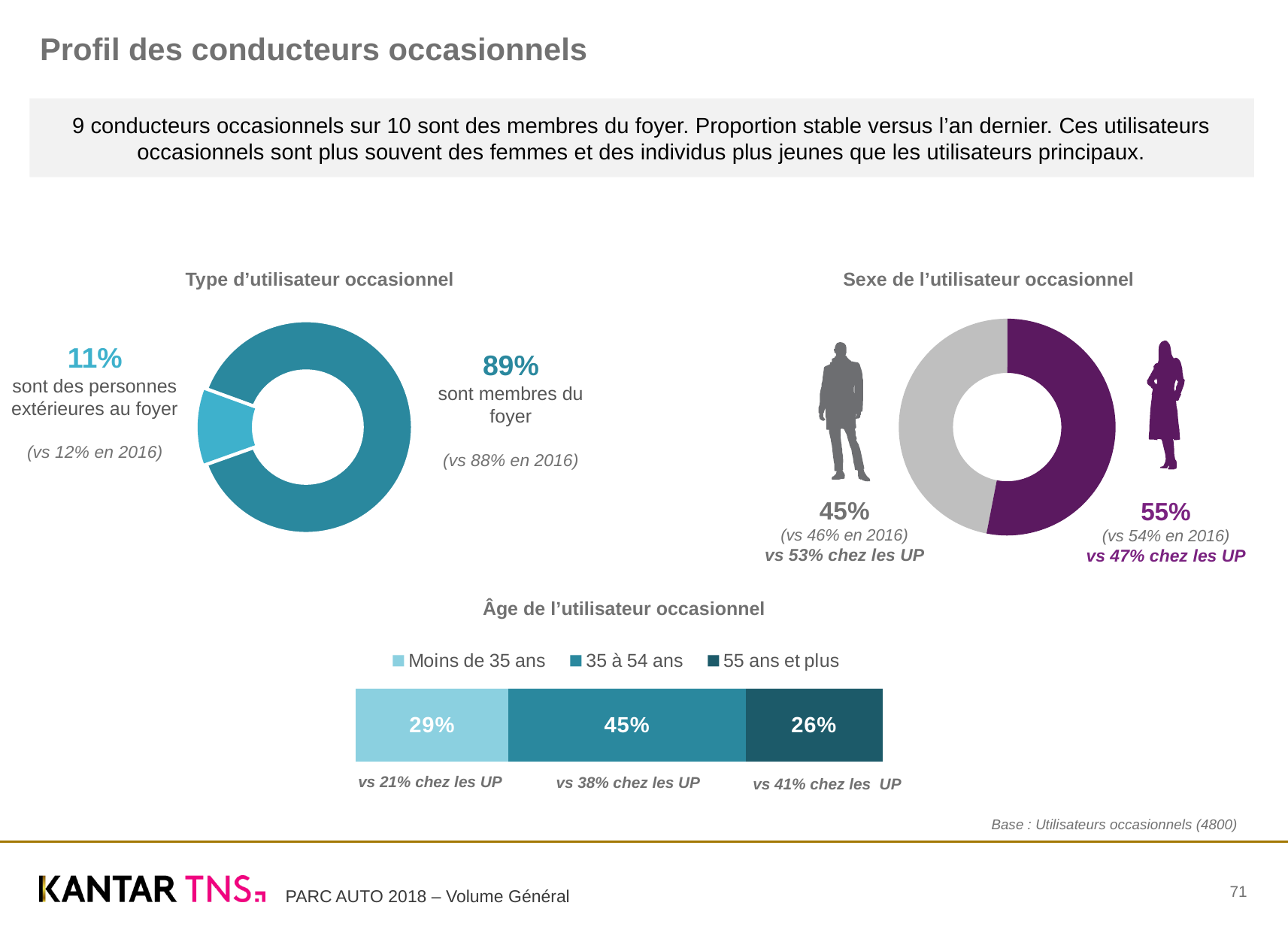
In the 'Type d'utilisateur occasionnel' chart, what percentage of occasional users are members of the household (membres du foyer)? 89% In the 'Sexe de l'utilisateur occasionnel' chart, what is the difference in percentage points between women and men? 10 percentage points In the 'Sexe de l'utilisateur occasionnel' chart, what percentage of occasional users are men? 45% In the 'Sexe de l'utilisateur occasionnel' chart, which group is larger, men or women? Women In the 'Type d'utilisateur occasionnel' chart, what is the difference in percentage points between household members and people from outside the household? 78 percentage points What kind of chart is the 'Type d'utilisateur occasionnel' chart? Donut (pie) chart In the 'Âge de l'utilisateur occasionnel' chart, what is the total of the three segments of the stacked bar? 100% In the 'Sexe de l'utilisateur occasionnel' chart, what percentage of occasional users are women? 55% How many series does the legend of the 'Âge de l'utilisateur occasionnel' chart list? 3 In the 'Type d'utilisateur occasionnel' chart, what percentage of occasional users are people from outside the household (personnes extérieures au foyer)? 11% In the 'Âge de l'utilisateur occasionnel' chart, what is the value for '35 à 54 ans'? 45% In the 'Âge de l'utilisateur occasionnel' chart, which age group has the smallest share? 55 ans et plus